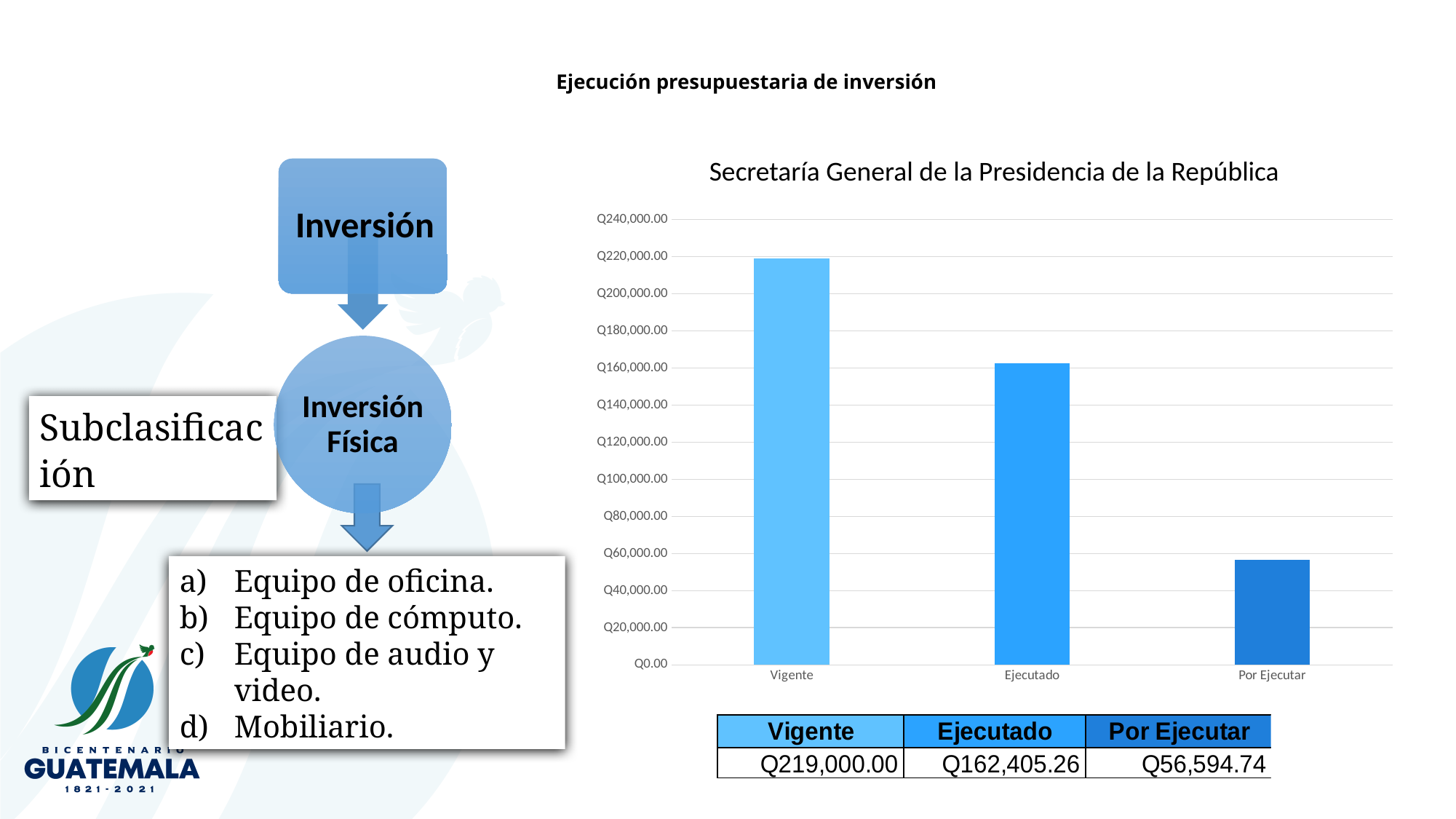
What kind of chart is shown on the slide? Bar chart What is the title of the chart? Secretaría General de la Presidencia de la República How many categories are shown in the chart? 3 Is the value for Ejecutado greater or less than Q140,000.00? greater Which is larger, the value for Ejecutado or the value for Por Ejecutar? Ejecutado What is the difference between the Ejecutado and Por Ejecutar values? Q105,810.52 What is the difference between the Vigente and Ejecutado values? Q56,594.74 Which category has the lowest value in the chart? Por Ejecutar Which category has the highest value in the chart? Vigente What is the value for Ejecutado in the chart? Q162,405.26 What is the value for Por Ejecutar in the chart? Q56,594.74 What is the value for Vigente in the chart? Q219,000.00